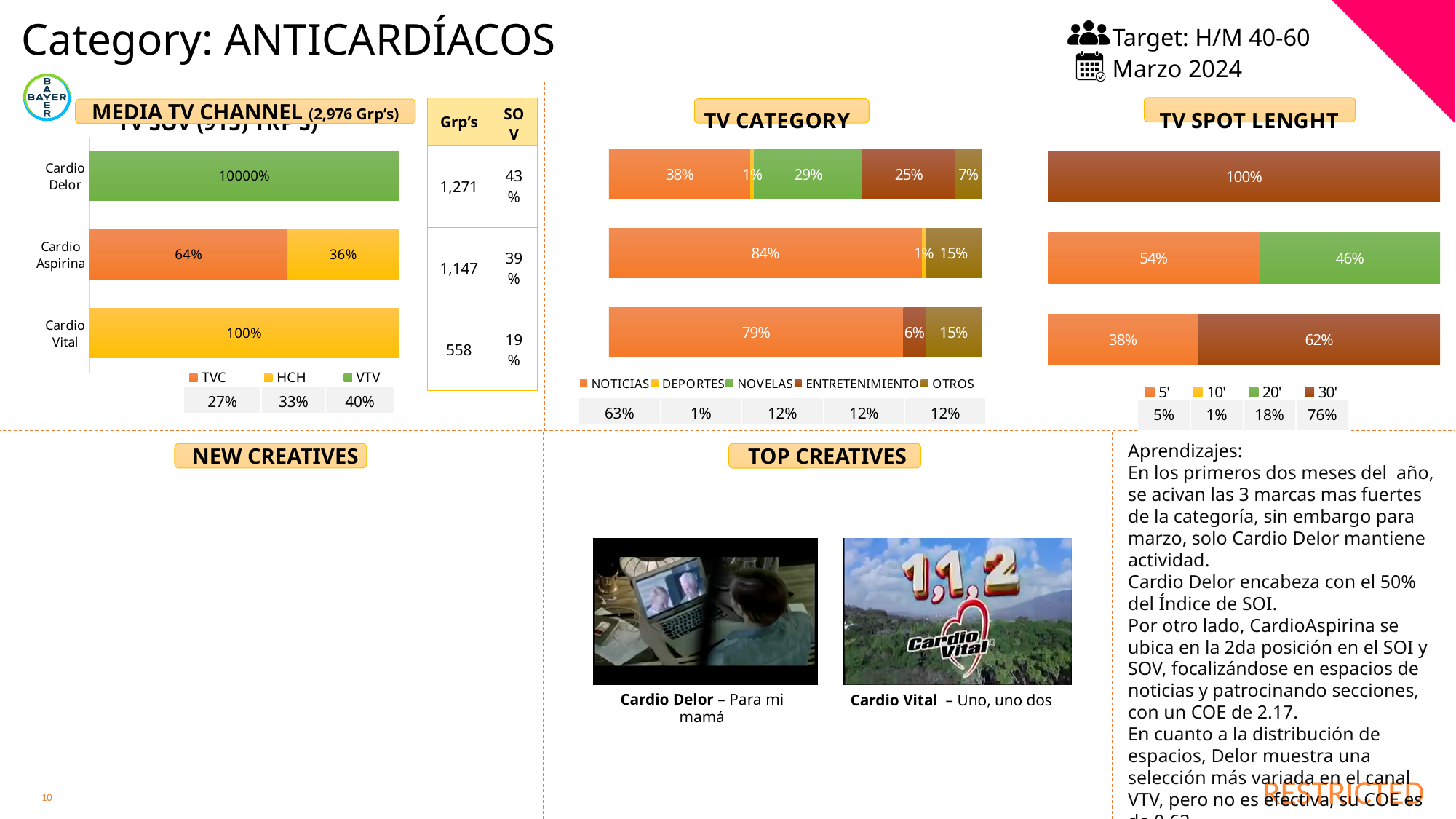
In the MEDIA TV CHANNEL chart, what is the HCH value for Cardio Vital? 100% In the MEDIA TV CHANNEL chart, what is the TVC value for Cardio Aspirina? 64% What kind of chart is the TV CATEGORY chart? Stacked bar chart In the TV CATEGORY chart, which segment is the largest in the top bar? NOTICIAS In the TV SPOT LENGHT chart, what is the 30' value in the bottom bar? 62% How many series does the legend of the MEDIA TV CHANNEL chart list? 3 How many brands (categories) are shown in the MEDIA TV CHANNEL chart? 3 How many series does the legend of the TV CATEGORY chart list? 5 In the TV CATEGORY chart, what is the difference between the NOTICIAS value in the middle bar (84%) and in the bottom bar (79%)? 5 percentage points How many series does the legend of the TV SPOT LENGHT chart list? 4 In the TV SPOT LENGHT chart, which is larger in the middle bar: the 5' segment or the 20' segment? 5' (54%) In the TV CATEGORY chart, what is the NOTICIAS value in the middle bar? 84%